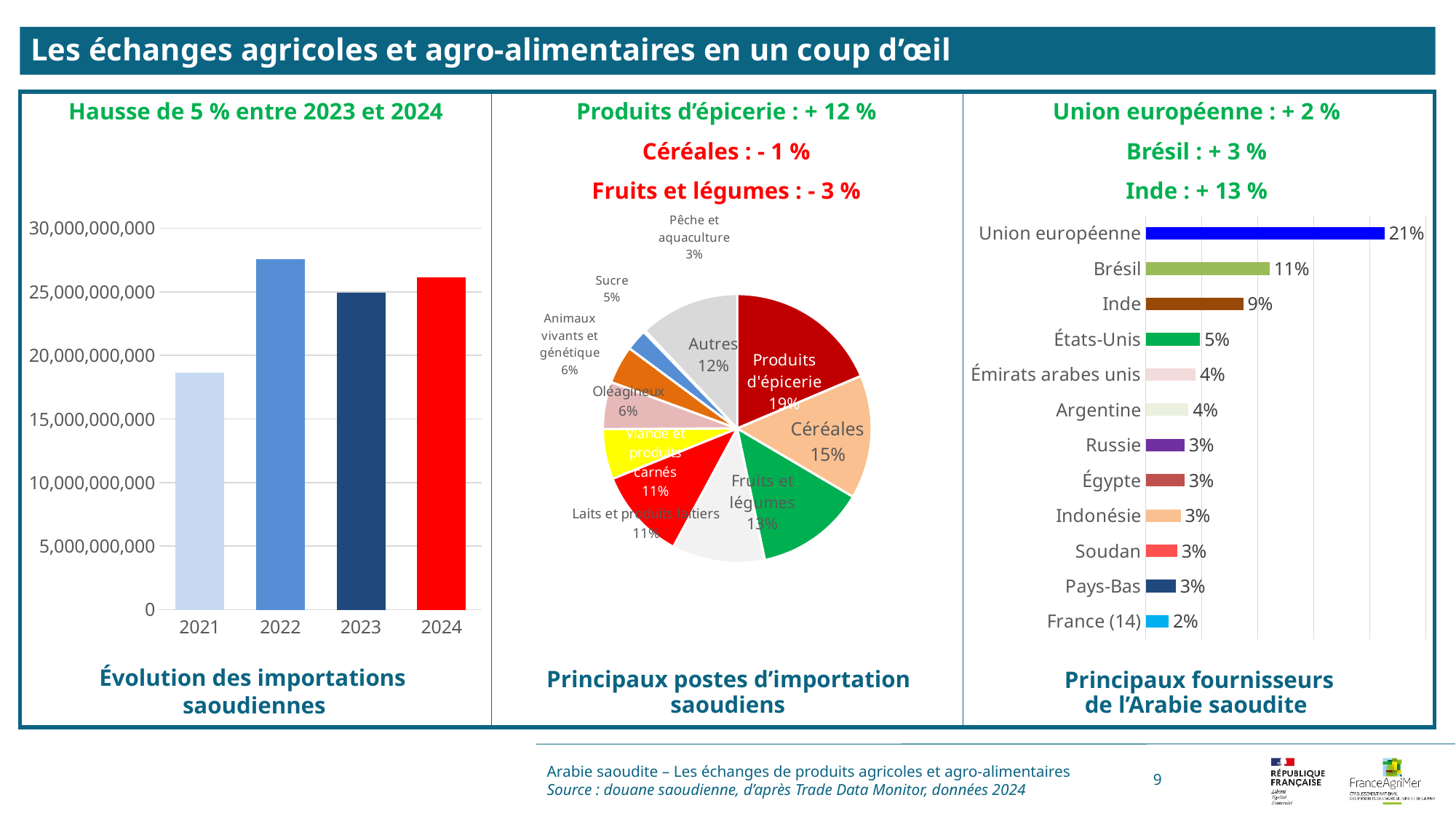
In the chart 'Évolution des importations saoudiennes', which year has the highest bar? 2022 How many years are shown in the chart 'Évolution des importations saoudiennes'? 4 In the pie chart 'Principaux postes d'importation saoudiens', what is the difference between Produits d'épicerie and Fruits et légumes? 6% In the pie chart 'Principaux postes d'importation saoudiens', which category has the largest slice? Produits d'épicerie In the chart 'Principaux fournisseurs de l'Arabie saoudite', what is the value for Inde? 9% In the chart 'Évolution des importations saoudiennes', which year has the lowest bar? 2021 In the chart 'Évolution des importations saoudiennes', is the value for 2021 greater or less than 20,000,000,000? less In the chart 'Principaux fournisseurs de l'Arabie saoudite', which supplier has the lowest value? France (14) In the pie chart 'Principaux postes d'importation saoudiens', what share does Céréales have? 15% In the chart 'Évolution des importations saoudiennes', is the value for 2022 greater or less than 25,000,000,000? greater What kind of chart is 'Principaux postes d'importation saoudiens'? Pie chart In the chart 'Principaux fournisseurs de l'Arabie saoudite', how many suppliers are listed? 12